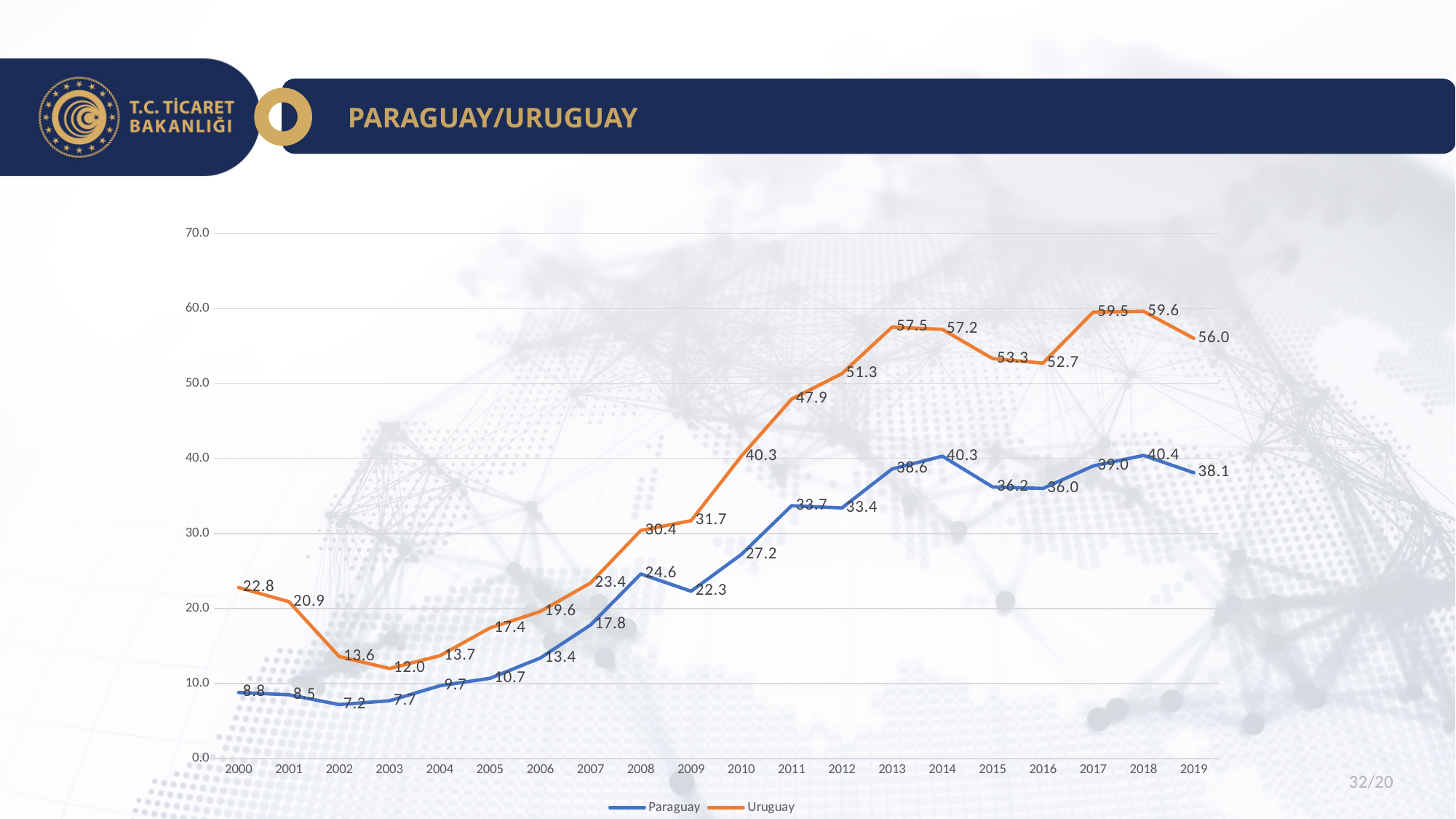
How many years are shown on the x axis? 20 What is the difference between the Uruguay and Paraguay values in 2019? 17.9 In which year is the Uruguay series at its lowest? 2003 What is the value for Uruguay in 2019? 56.0 How many series does the legend list? 2 What is the difference between the Paraguay values in 2014 and 2015? 4.1 What kind of chart is shown on the slide? Line chart What is the value for Uruguay in 2011? 47.9 What is the value for Paraguay in 2008? 24.6 Does the Uruguay series rise or fall between 2003 and 2013? Rise In which year is the Paraguay series at its lowest? 2002 Which series has the higher value in 2013, Paraguay or Uruguay? Uruguay